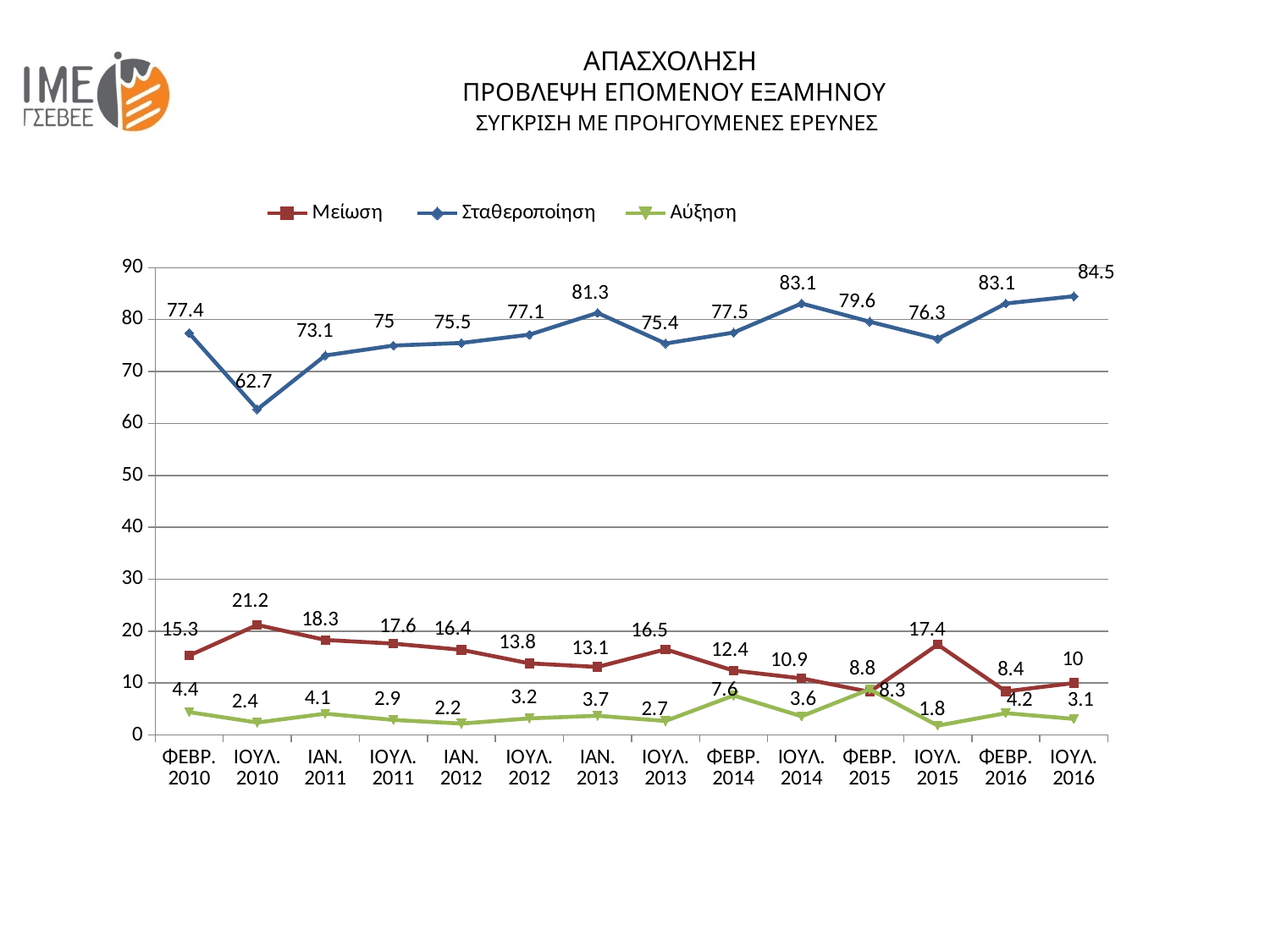
At which time point is Σταθεροποίηση lowest? ΙΟΥΛ. 2010 Which is larger, Μείωση for ΙΑΝ. 2013 or Μείωση for ΙΟΥΛ. 2013? ΙΟΥΛ. 2013 What is the value of Σταθεροποίηση for ΙΟΥΛ. 2016? 84.5 What type of chart is shown on the slide? line chart What is the value of Αύξηση for ΦΕΒΡ. 2014? 7.6 How many series does the legend list? 3 How many time points are shown on the x axis? 14 At which time point is Αύξηση lowest? ΙΟΥΛ. 2015 What is the value of Μείωση for ΙΟΥΛ. 2010? 21.2 Which series is shown in blue in the legend? Σταθεροποίηση What is the difference between Σταθεροποίηση for ΙΟΥΛ. 2016 and ΦΕΒΡ. 2010? 7.1 At which time point is Μείωση highest? ΙΟΥΛ. 2010